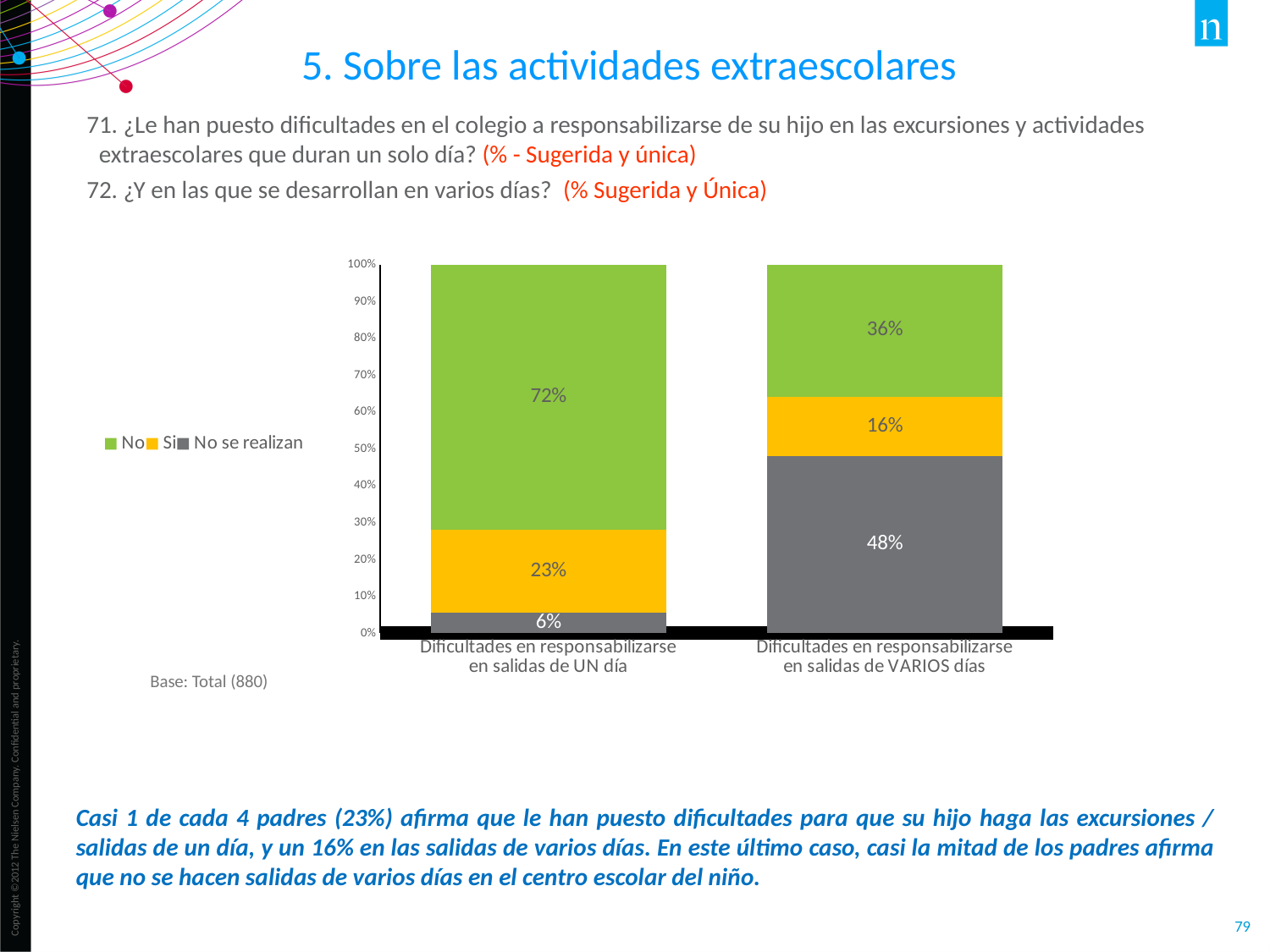
What is the value for "No" in the "Dificultades en responsabilizarse en salidas de VARIOS días" bar? 36% What is the value for "No se realizan" in the "Dificultades en responsabilizarse en salidas de UN día" bar? 6% Which category has the lower value for "Si"? Dificultades en responsabilizarse en salidas de VARIOS días Is the "Si" value for salidas de UN día larger or smaller than the "Si" value for salidas de VARIOS días? larger What is the difference between the "No" values for salidas de UN día and salidas de VARIOS días? 36% Which category has the higher value for "No": salidas de UN día or salidas de VARIOS días? Dificultades en responsabilizarse en salidas de UN día What kind of chart is shown on the slide? Stacked bar chart What is the difference between the "No se realizan" values for salidas de VARIOS días and salidas de UN día? 42% What is the value for "No se realizan" in the "Dificultades en responsabilizarse en salidas de VARIOS días" bar? 48% How many series does the legend list? 3 How many categories are shown on the x axis? 2 What is the value for "Si" in the "Dificultades en responsabilizarse en salidas de UN día" bar? 23%